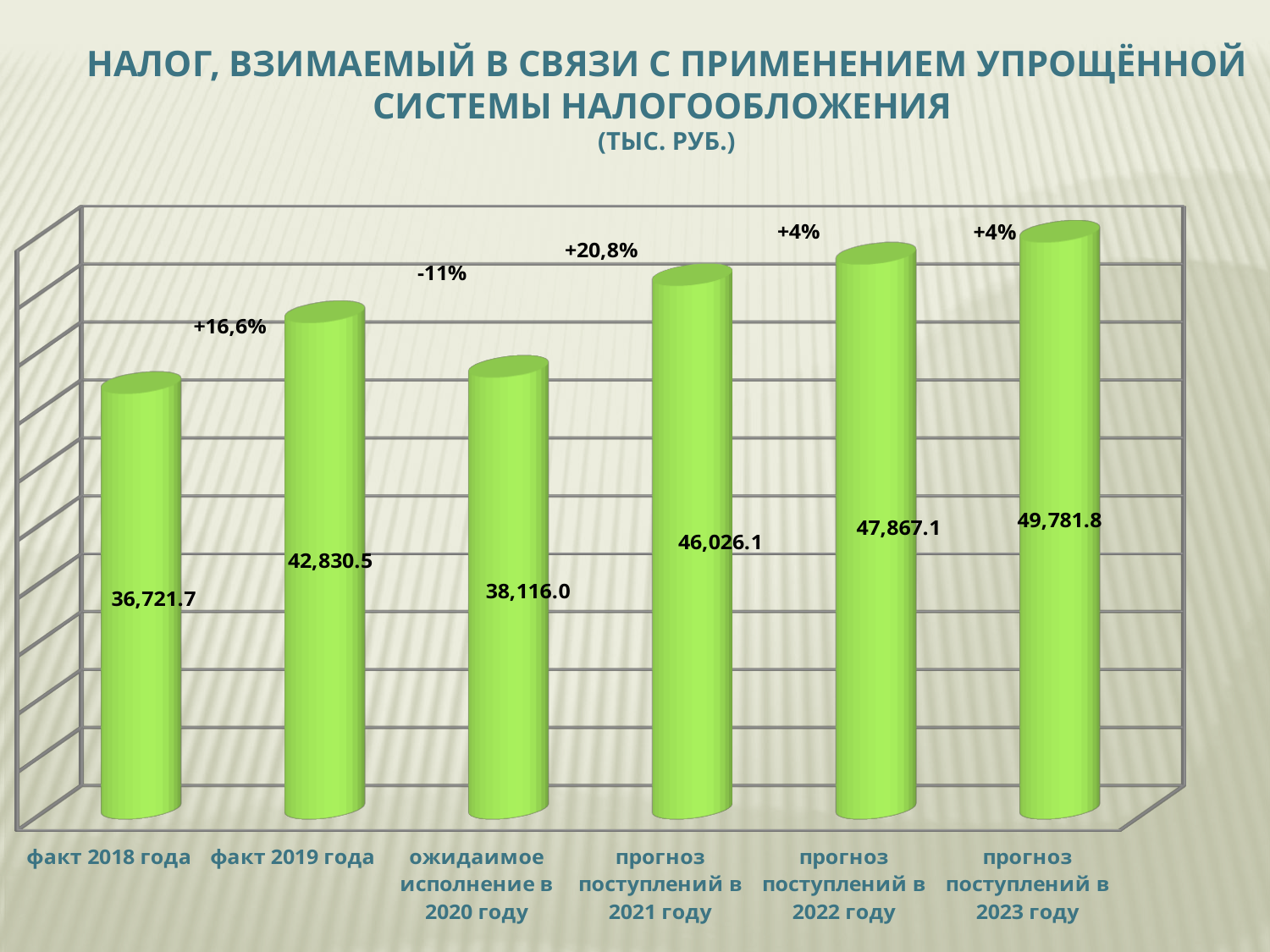
What is the value for прогноз поступлений в 2023 году? 49,781.8 How many categories are shown in the chart? 6 What unit is given in the chart title? тыс. руб. What is the value for ожидаимое исполнение в 2020 году? 38,116.0 What percentage change is annotated above the bar for прогноз поступлений в 2021 году? +20,8% What is the difference between the values for прогноз поступлений в 2022 году and прогноз поступлений в 2021 году? 1,841.0 Which is larger, the value for факт 2019 года or the value for ожидаимое исполнение в 2020 году? факт 2019 года What is the value for факт 2018 года? 36,721.7 Which category has the highest value? прогноз поступлений в 2023 году What is the value for факт 2019 года? 42,830.5 What kind of chart is shown on the slide? bar chart Which category has the lowest value? факт 2018 года